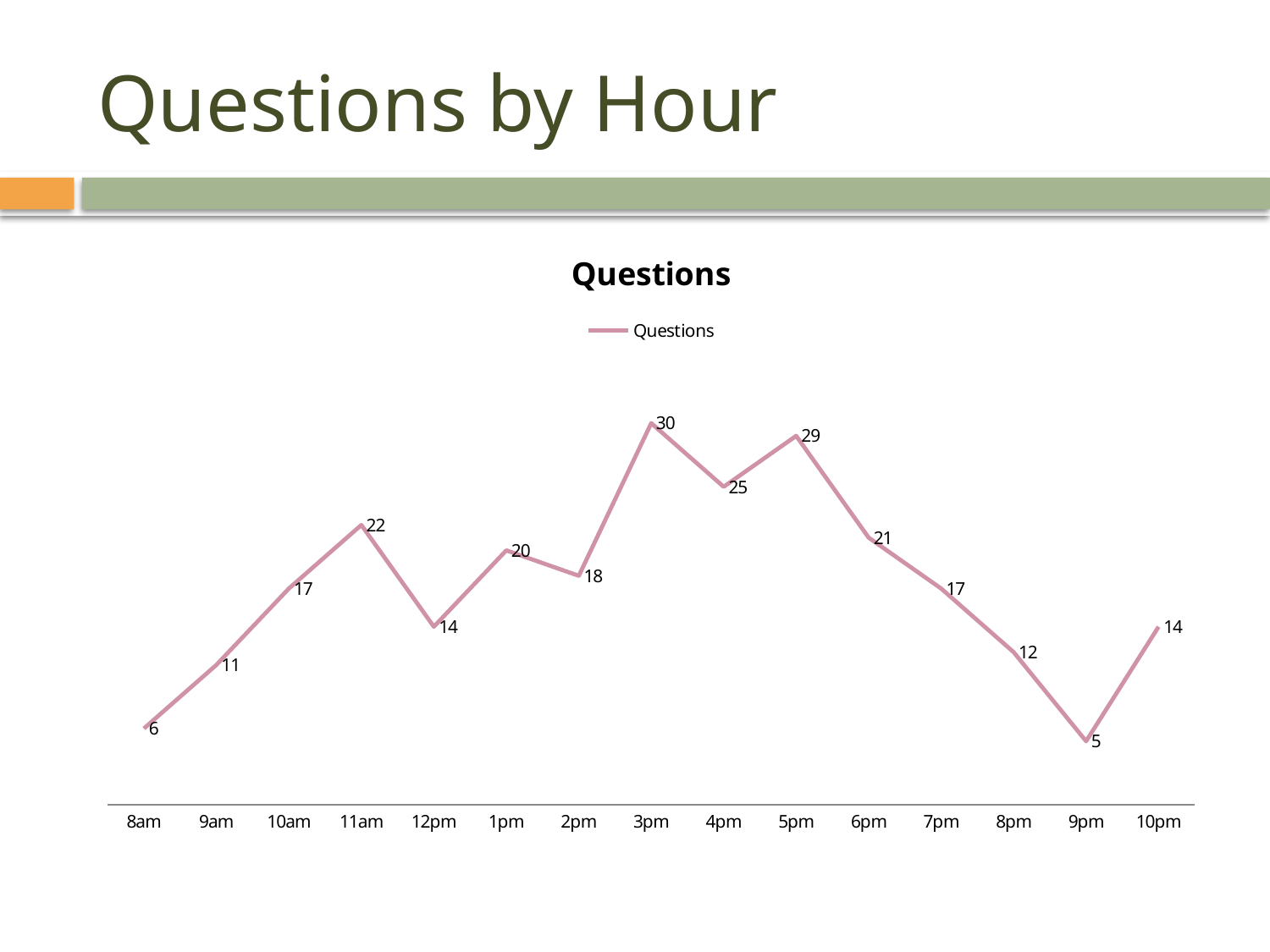
What is the value for 6pm? 21 Which hour has the highest value? 3pm What is the value for 8am? 6 What is the value for 3pm? 30 What kind of chart is shown? line chart Which hour has the lowest value? 9pm How many hours are plotted on the x axis? 15 Which is larger, the value for 11am or the value for 1pm? 11am What is the difference between the values for 5pm and 4pm? 4 How many series does the legend list? 1 What is the title of the chart? Questions Do the values rise or fall from 5pm to 9pm? fall